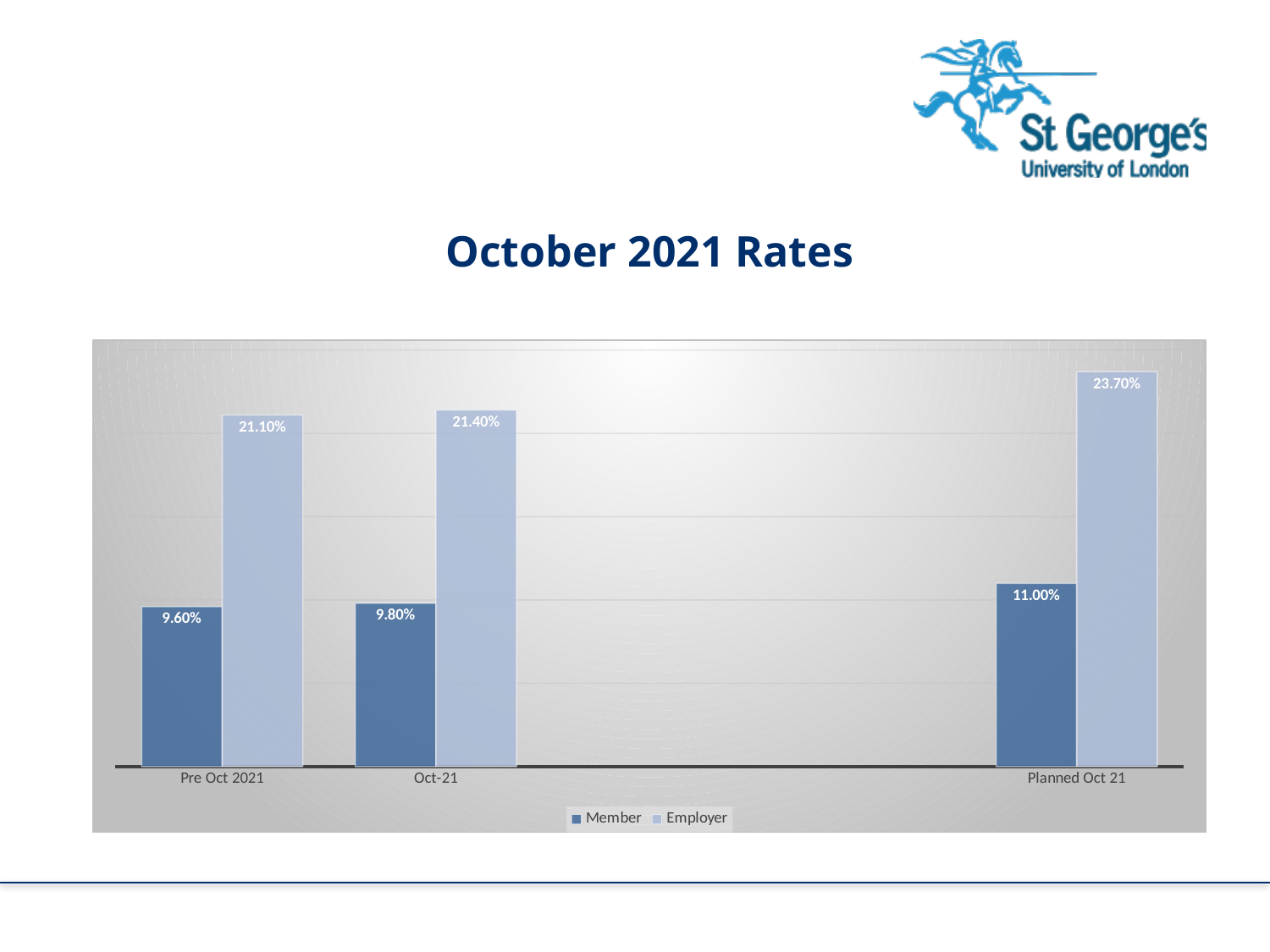
What kind of chart is shown on the slide? Bar chart Which is larger, the Employer rate for Pre Oct 2021 or the Employer rate for Oct-21? Employer rate for Oct-21 What is the Employer rate for Oct-21? 21.40% Which category has the lowest Member rate? Pre Oct 2021 Do the Member rates rise or fall from Pre Oct 2021 to Planned Oct 21? Rise What is the Member rate for Planned Oct 21? 11.00% How many series does the legend list? 2 How many categories are shown on the x axis? 3 Which category has the highest Employer rate? Planned Oct 21 What is the Member rate for Pre Oct 2021? 9.60% What is the difference between the Employer rate and the Member rate for Oct-21? 11.60% What is the Employer rate for Planned Oct 21? 23.70%